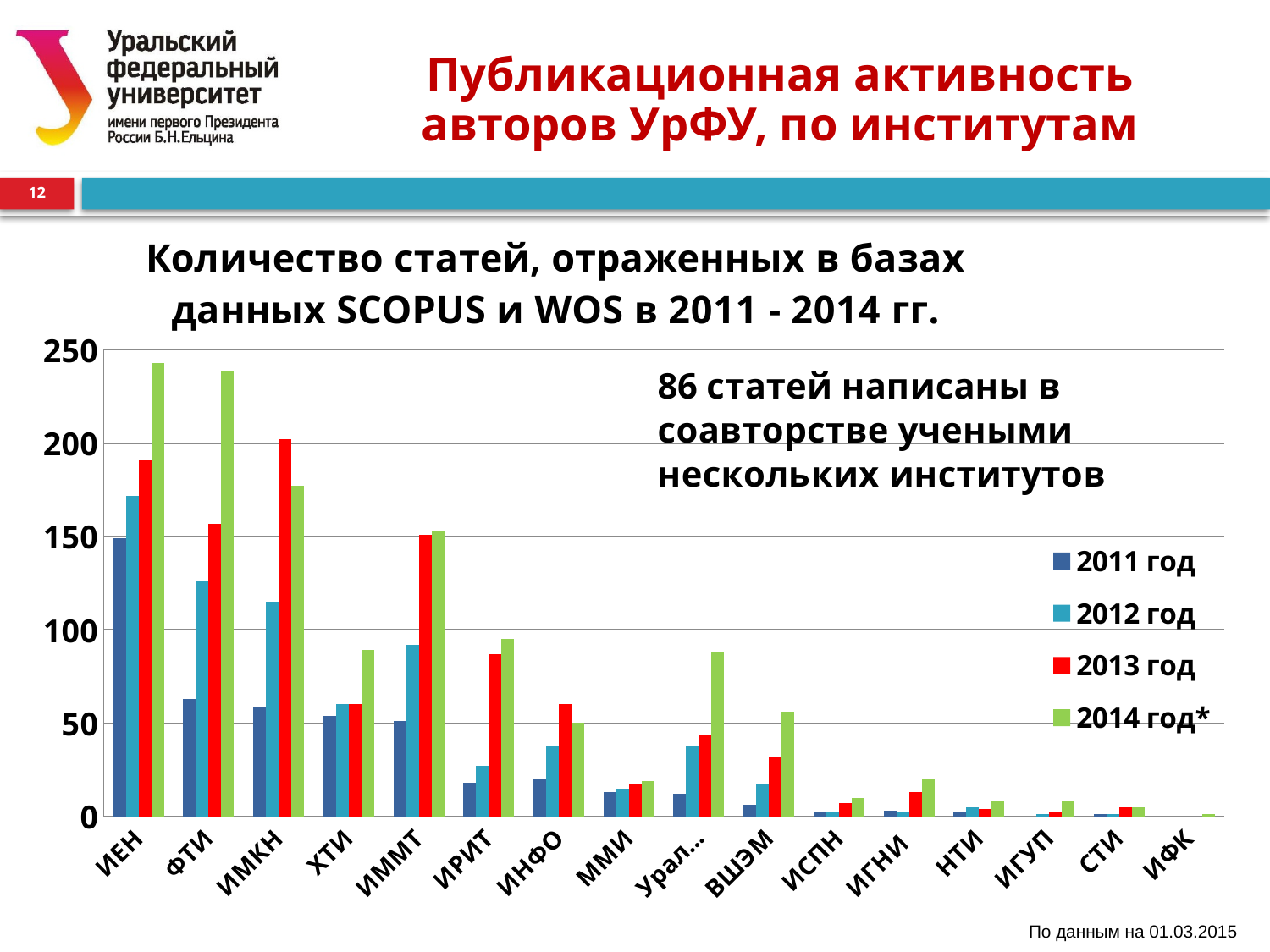
How many institutes (categories) are shown on the x axis? 16 Is the value for ХТИ in 2014 год* greater or less than 100? less Which is larger for ИМКН: the value for 2013 год or the value for 2014 год*? 2013 год Which legend entry is marked with an asterisk? 2014 год* Which institute has the highest value for 2012 год? ИЕН What kind of chart is shown on the slide? Bar chart Which is larger for ФТИ: the value for 2013 год or the value for 2014 год*? 2014 год* Which institute has the lowest value for 2014 год*? ИФК Is the value for ФТИ in 2012 год greater or less than 150? less Which institute has the highest value for 2011 год? ИЕН Is the value for ИЕН in 2011 год greater or less than 100? greater How many series does the legend list? 4